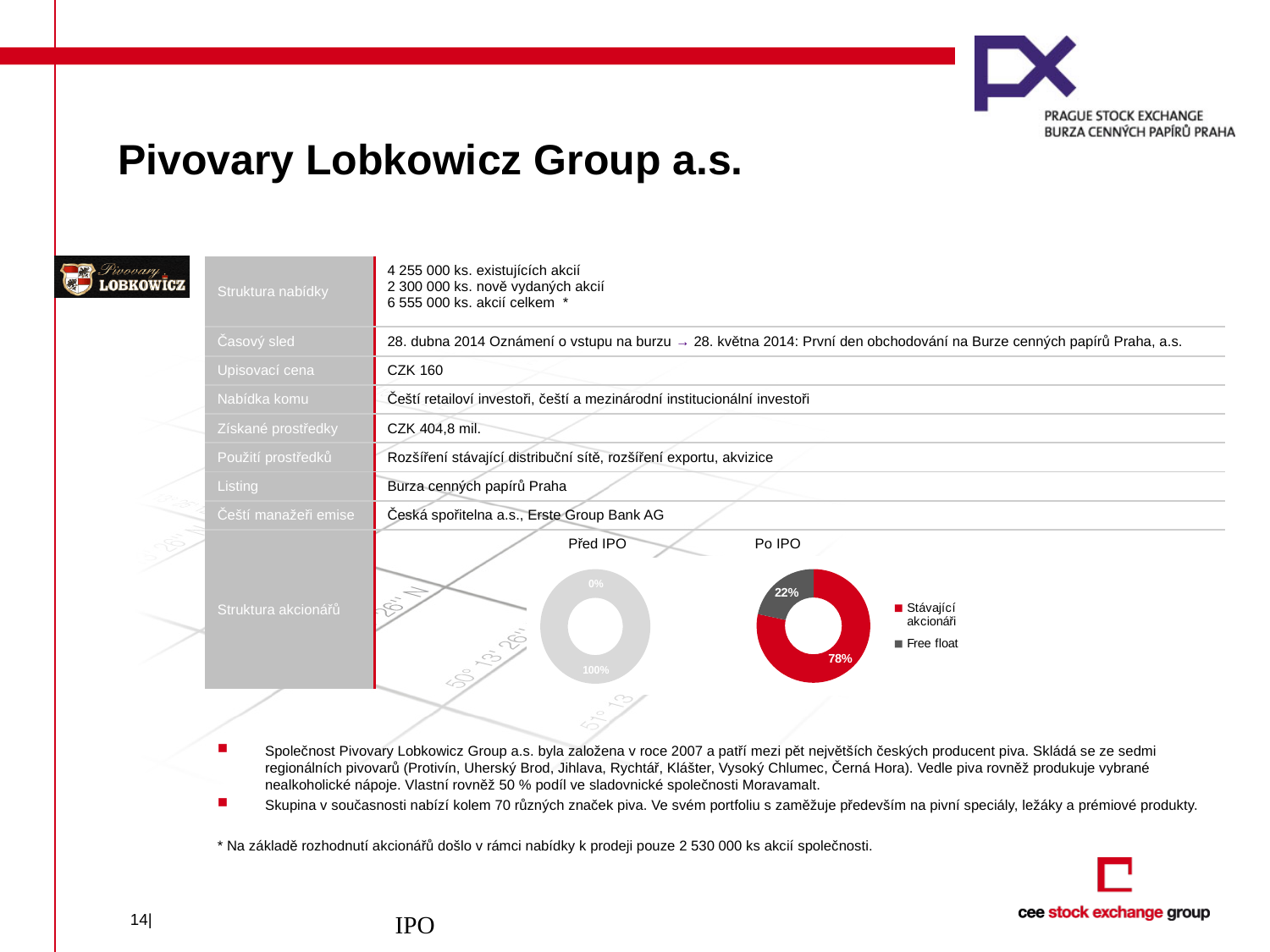
What are the titles of the two pie charts in the 'Struktura akcionářů' row? Před IPO and Po IPO What is the largest share labelled on the 'Před IPO' chart? 100% In the 'Po IPO' chart, which slice is larger: Stávající akcionáři or Free float? Stávající akcionáři In the 'Po IPO' chart, what share do Stávající akcionáři hold? 78% How many pie charts are shown in the 'Struktura akcionářů' row? 2 In the 'Po IPO' chart, what colour represents Stávající akcionáři? Red In the 'Po IPO' chart, what is the difference between the Stávající akcionáři share and the Free float share? 56 percentage points What is the smallest share labelled on the 'Před IPO' chart? 0% In the 'Po IPO' chart, which category has the smallest share? Free float How many entries does the legend of the shareholder structure charts list? 2 What kind of chart is used for the 'Po IPO' shareholder structure? Pie (donut) chart In the 'Po IPO' chart, what share is Free float? 22%